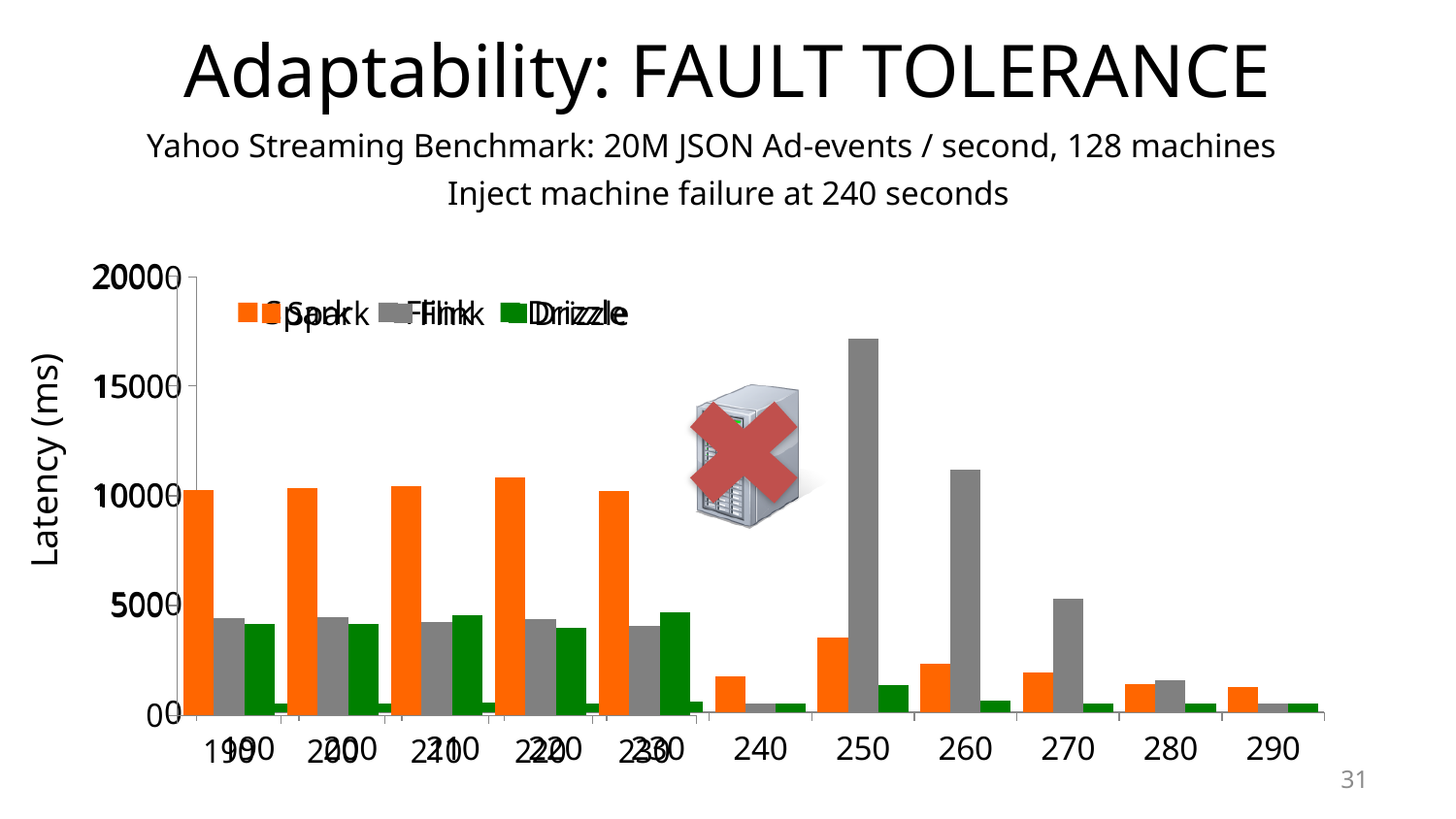
Do the Flink values rise or fall from 250 to 290? fall Which series has the highest value at 250? Flink Is the Flink value at 260 greater or less than 10000? greater What are the series names listed in the chart's legend? Spark, Flink, Drizzle Is the Drizzle value at 250 greater or less than 5000? less How many x-axis categories (time points) are shown on the chart? 11 Is the Flink value at 250 greater or less than 15000? greater What kind of chart is shown on the slide? bar chart Which series has the highest value at 220? Spark What is the label on the chart's y axis? Latency (ms) How many series does the chart's legend list? 3